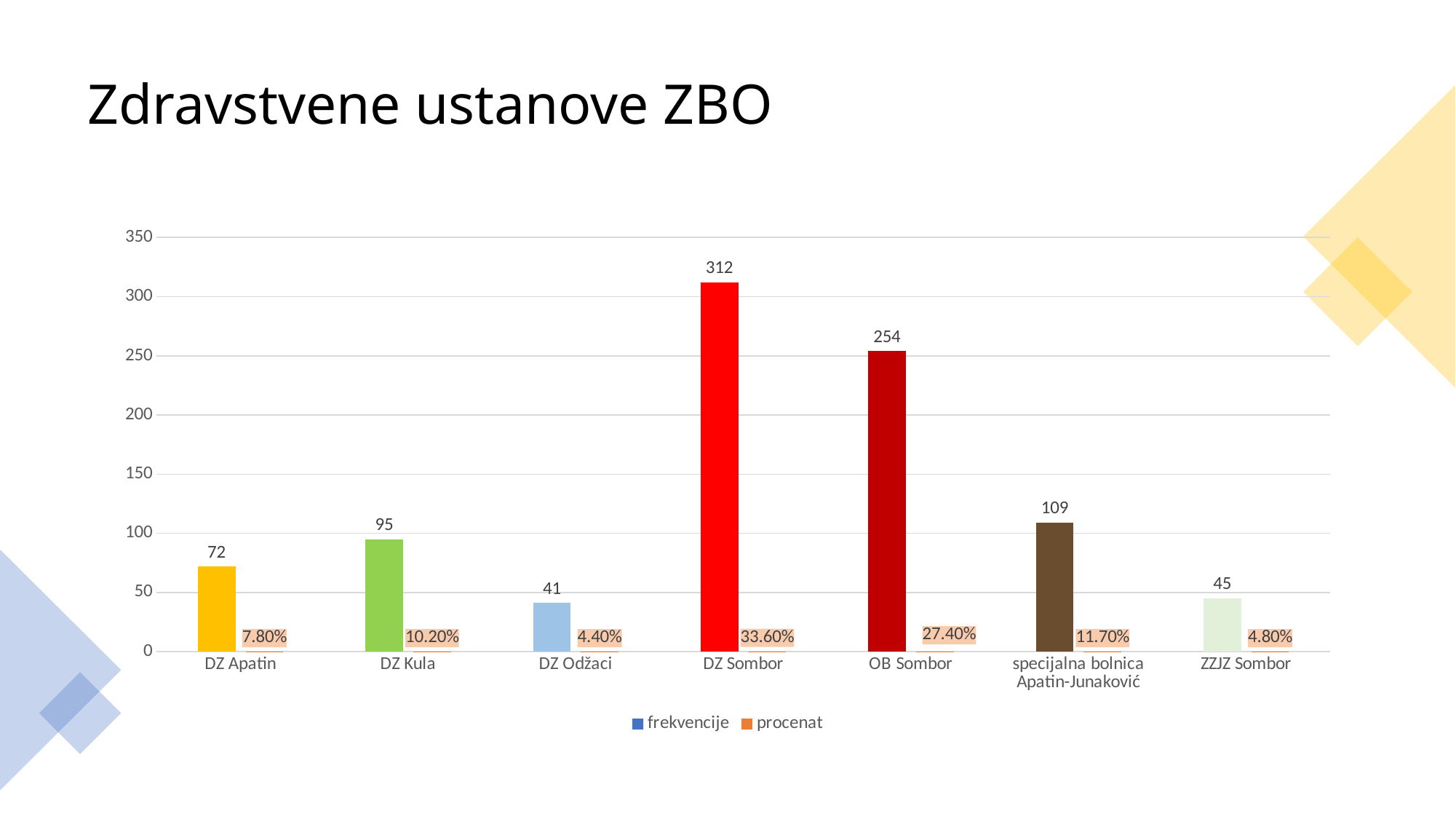
What kind of chart is shown on the slide? bar chart What is the procenat value for OB Sombor? 27.40% Which has a larger frekvencije value, DZ Kula or DZ Apatin? DZ Kula Which category has the lowest frekvencije value? DZ Odžaci What is the frekvencije value for DZ Sombor? 312 What is the difference between the frekvencije values for DZ Sombor and OB Sombor? 58 What is the procenat value for ZZJZ Sombor? 4.80% How many categories are shown on the x axis? 7 Which category has the highest frekvencije value? DZ Sombor Is the frekvencije value for OB Sombor greater or less than 200? greater How many series does the legend list? 2 What is the frekvencije value for specijalna bolnica Apatin-Junaković? 109